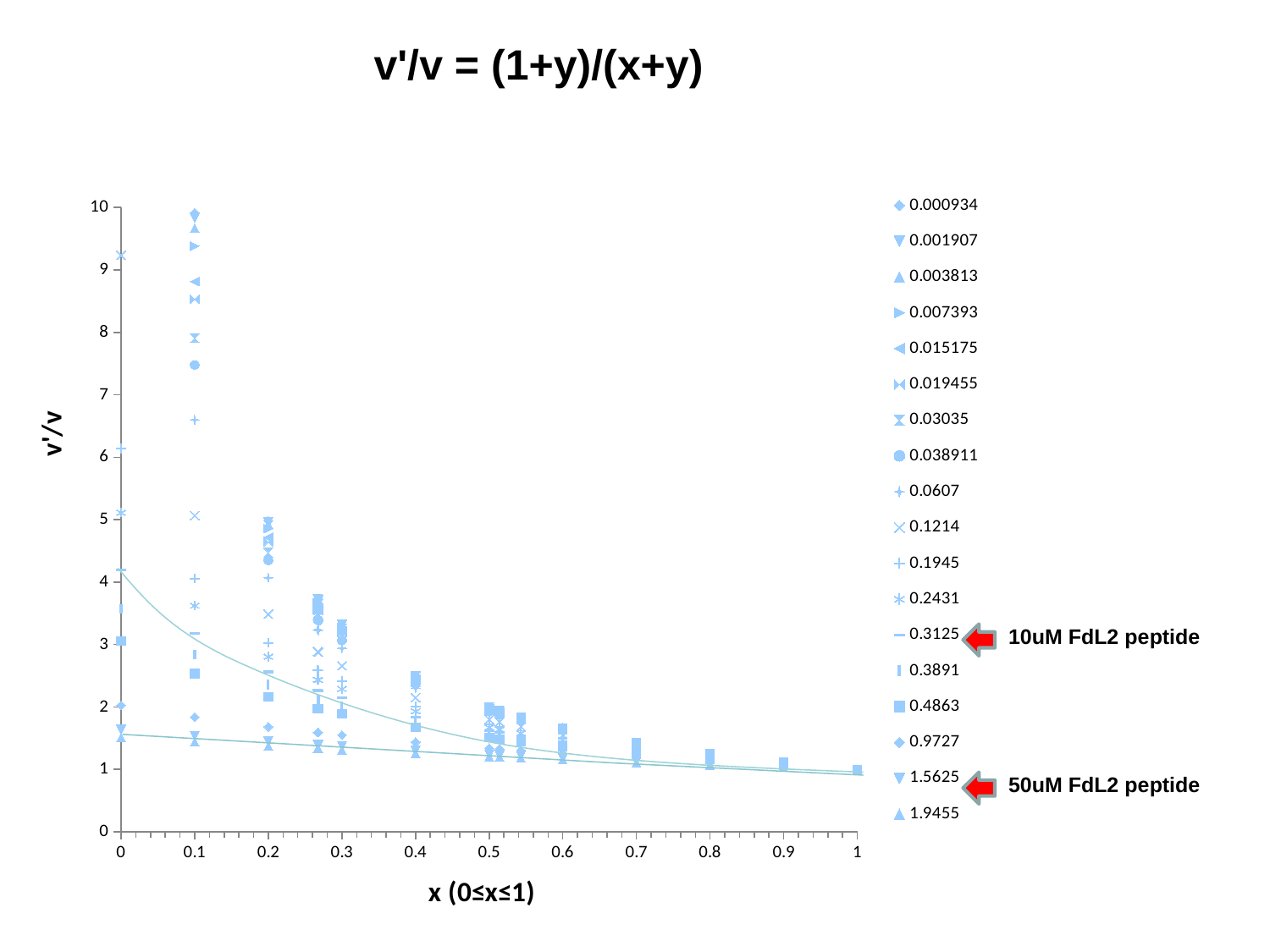
Is the value for series 0.0607 at x = 0.1 greater or less than 6? greater How many labelled tick marks are on the x axis? 11 Is the value for series 0.038911 at x = 0.1 greater or less than 7? greater Which legend entry is annotated with the arrow labelled '10uM FdL2 peptide'? 0.3125 At x = 0.1, which series has the larger value: 0.000934 or 0.9727? 0.000934 Is the value for series 0.000934 at x = 0.1 greater or less than 9? greater What kind of chart is shown on the slide? scatter chart How many series does the legend list? 18 Which legend entry is annotated with the arrow labelled '50uM FdL2 peptide'? 1.5625 Do the plotted v'/v values rise or fall as x increases from 0 to 1? fall